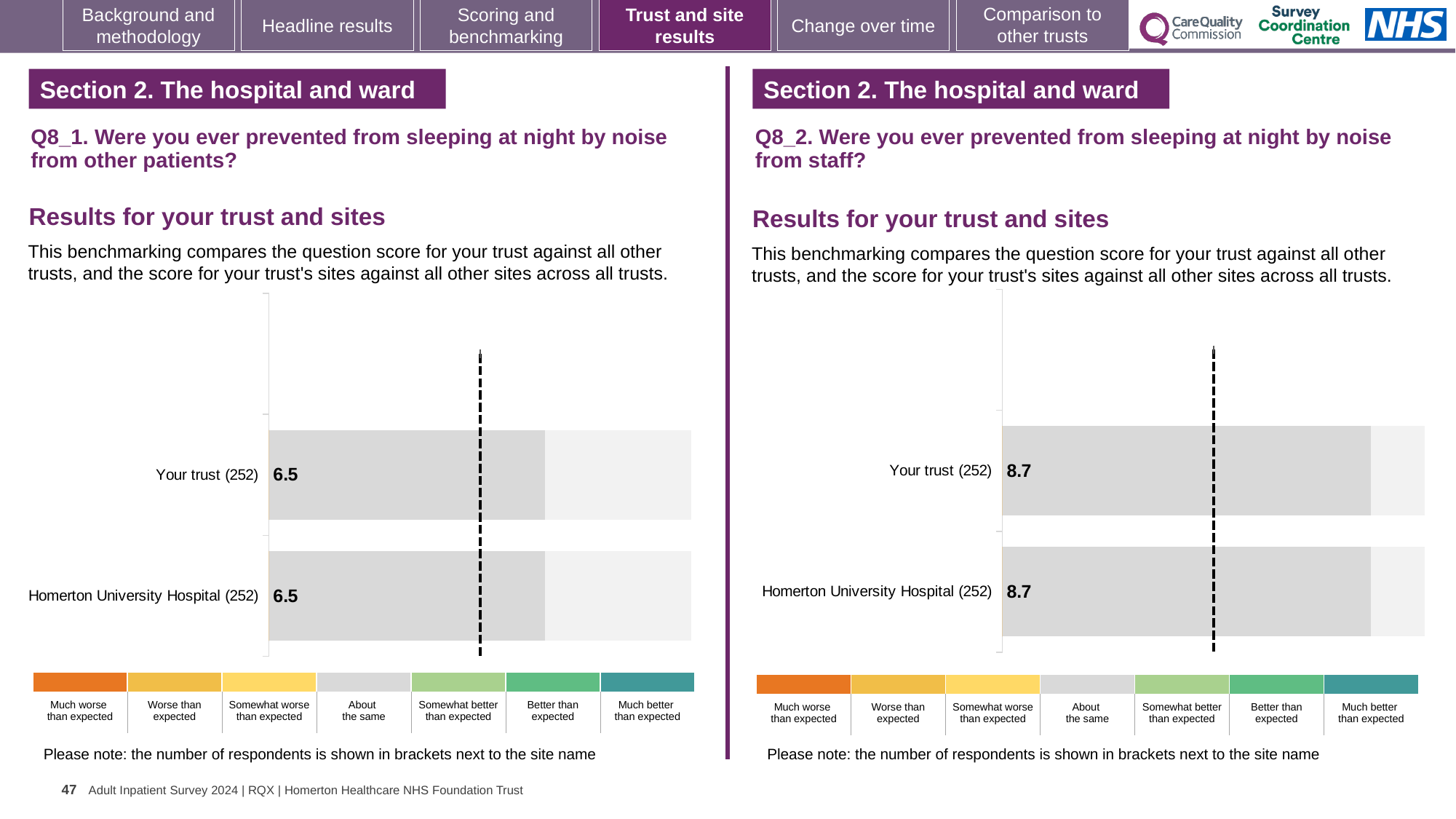
On the Q8_2 chart (right), what is the score for Your trust (252)? 8.7 On the Q8_1 chart (left), how many respondents are shown in brackets next to Homerton University Hospital? 252 Is the score for Your trust on the Q8_2 chart (right) larger or smaller than the score for Your trust on the Q8_1 chart (left)? Larger What kind of chart is used on the Q8_2 chart (right)? Bar chart On the Q8_1 chart (left), what is the score for Homerton University Hospital (252)? 6.5 How many bars are plotted on the Q8_1 chart (left)? 2 On the Q8_1 chart (left), what is the score for Your trust (252)? 6.5 On the Q8_1 chart (left), what is the difference between the score for Your trust and the score for Homerton University Hospital? 0.0 On the Q8_2 chart (right), which benchmarking category does the grey colour of the bars correspond to in the legend? About the same On the Q8_2 chart (right), what is the difference between the score for Your trust and the score for Homerton University Hospital? 0.0 How many bars are plotted on the Q8_2 chart (right)? 2 On the Q8_2 chart (right), what is the score for Homerton University Hospital (252)? 8.7